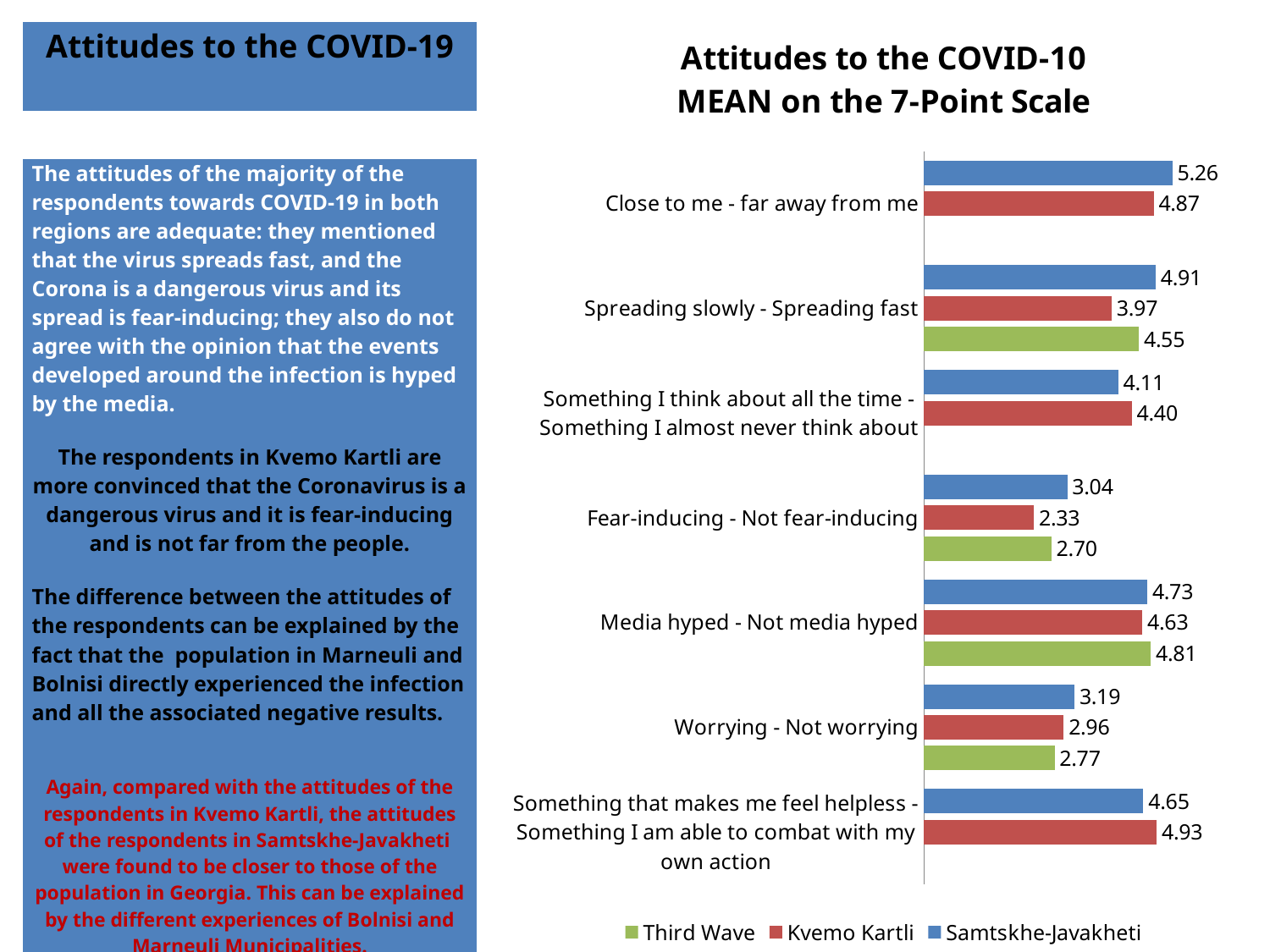
What is the Kvemo Kartli value for "Spreading slowly - Spreading fast"? 3.97 What is the Third Wave value for "Media hyped - Not media hyped"? 4.81 How many categories are plotted on the chart? 7 How many series does the legend list? 3 What is the difference between the Samtskhe-Javakheti and Kvemo Kartli values for "Spreading slowly - Spreading fast"? 0.94 What is the Samtskhe-Javakheti value for "Close to me - far away from me"? 5.26 Which colour represents the Third Wave series in the chart? green What is the difference between the Samtskhe-Javakheti and Third Wave values for "Worrying - Not worrying"? 0.42 What kind of chart is shown on the slide? bar chart Which category has the lowest Kvemo Kartli value? Fear-inducing - Not fear-inducing Which category has the highest Samtskhe-Javakheti value? Close to me - far away from me For "Something that makes me feel helpless - Something I am able to combat with my own action", which is larger: Kvemo Kartli or Samtskhe-Javakheti? Kvemo Kartli